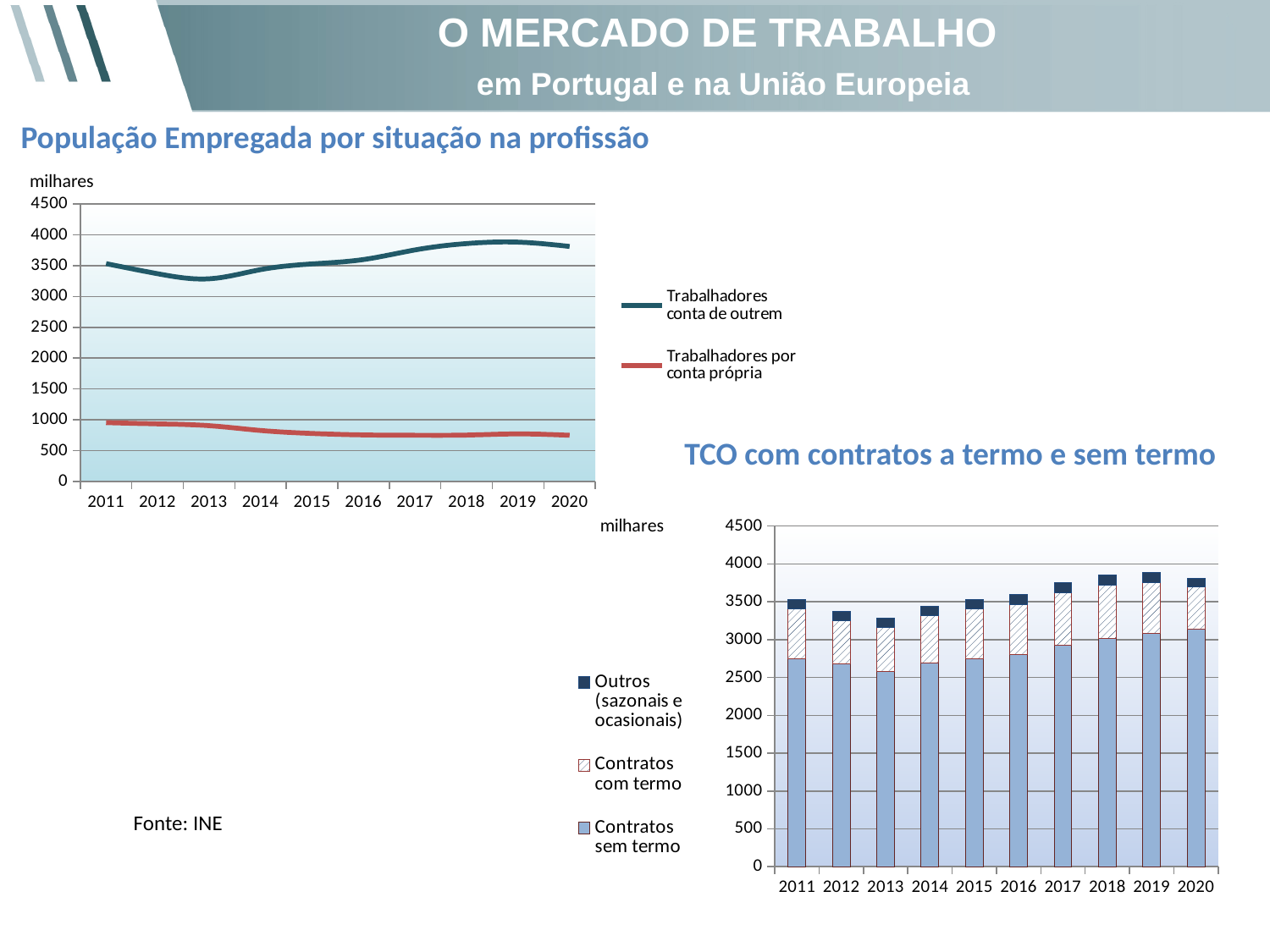
In the 'TCO com contratos a termo e sem termo' chart, how many stacked bars are there? 10 In the 'TCO com contratos a termo e sem termo' chart, which year has the shortest total stacked bar? 2013 In the 'População Empregada por situação na profissão' chart, how many series does the legend list? 2 In the 'População Empregada por situação na profissão' chart, in which year is 'Trabalhadores conta de outrem' lowest? 2013 In the 'População Empregada por situação na profissão' chart, how many years are shown on the x axis? 10 In the 'TCO com contratos a termo e sem termo' chart, how many series does the legend list? 3 In the 'População Empregada por situação na profissão' chart, is the value for 'Trabalhadores conta de outrem' in 2013 greater or less than 3500? less In the 'População Empregada por situação na profissão' chart, is the value for 'Trabalhadores por conta própria' in 2020 greater or less than 1000? less In the 'População Empregada por situação na profissão' chart, does the 'Trabalhadores por conta própria' line rise or fall from 2011 to 2020? fall What kind of chart is the 'População Empregada por situação na profissão' chart? line chart In the 'TCO com contratos a termo e sem termo' chart, is the value for 'Contratos sem termo' in 2020 greater or less than 3000? greater What kind of chart is the 'TCO com contratos a termo e sem termo' chart? bar chart